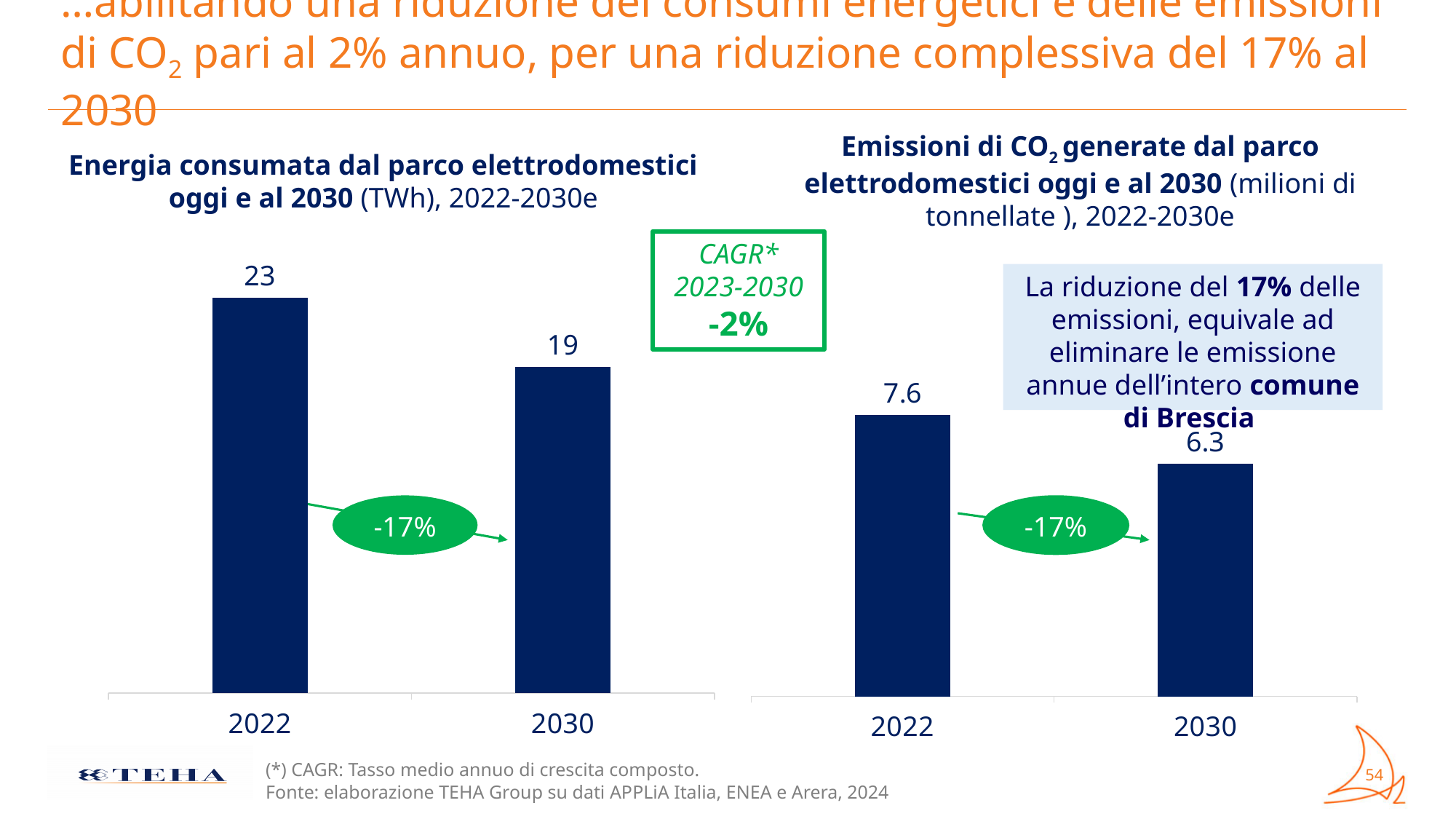
In the right chart (Emissioni di CO2 generate dal parco elettrodomestici), which year has the lower value? 2030 What percentage change is shown in the green oval between the two bars of the left chart (Energia consumata dal parco elettrodomestici)? -17% What type of chart is the left chart (Energia consumata dal parco elettrodomestici)? bar chart In the left chart (Energia consumata dal parco elettrodomestici), do the values rise or fall from 2022 to 2030? fall In the right chart (Emissioni di CO2 generate dal parco elettrodomestici), what is the value for 2030? 6.3 In the right chart (Emissioni di CO2 generate dal parco elettrodomestici), what is the difference between the 2022 and 2030 values? 1.3 In the left chart (Energia consumata dal parco elettrodomestici), what is the value for 2022? 23 How many bars are shown in the right chart (Emissioni di CO2 generate dal parco elettrodomestici)? 2 In the left chart (Energia consumata dal parco elettrodomestici), which year has the higher value? 2022 In the right chart (Emissioni di CO2 generate dal parco elettrodomestici), what is the value for 2022? 7.6 In the left chart (Energia consumata dal parco elettrodomestici), what is the difference between the 2022 and 2030 values? 4 In the left chart (Energia consumata dal parco elettrodomestici), what is the value for 2030? 19